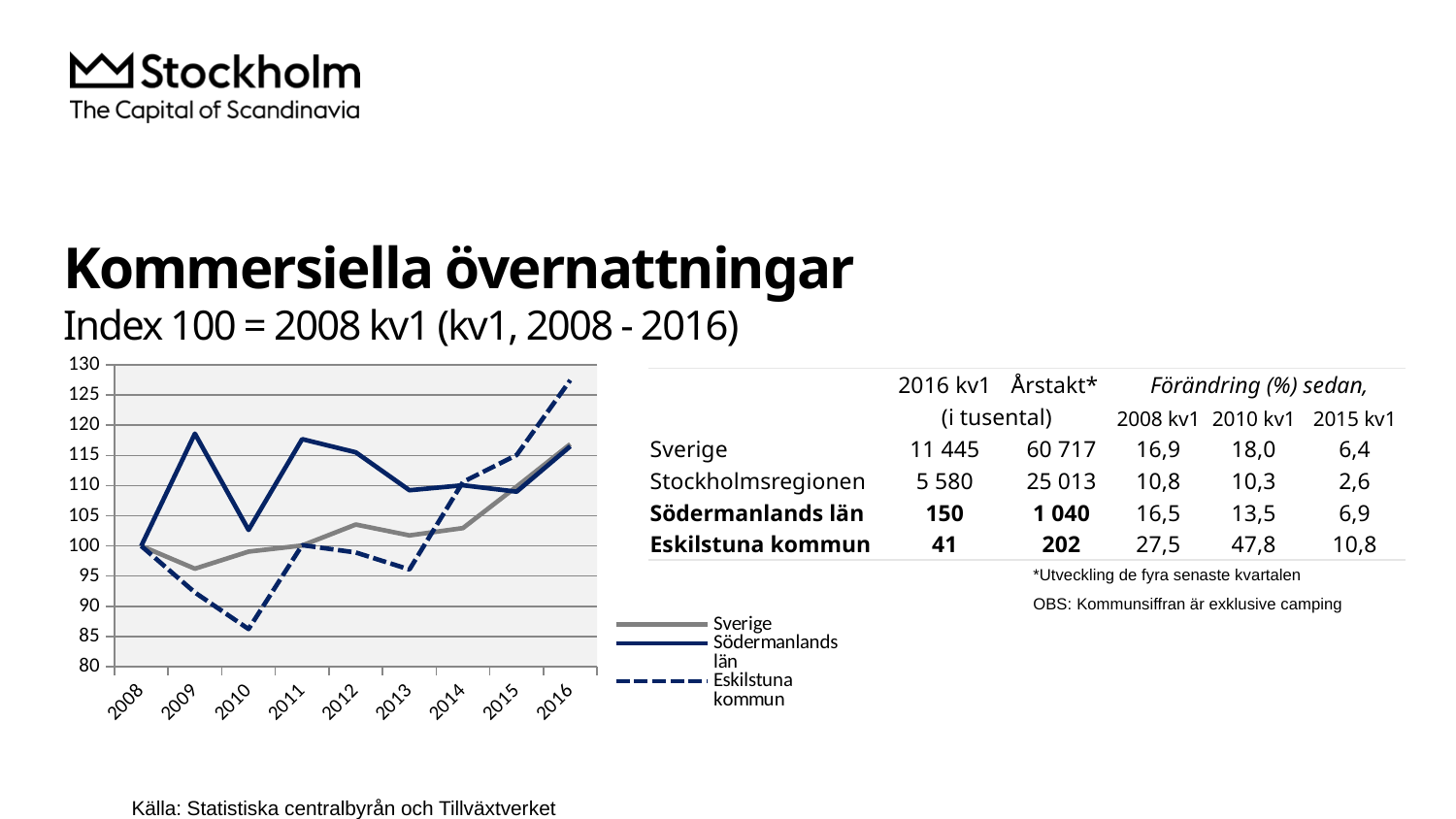
Which series has the lowest value in 2010? Eskilstuna kommun Is the value for Sverige in 2009 greater or less than 100? less What kind of chart is shown on the slide? line chart What is the index value for Sverige in 2008? 100 Is the value for Eskilstuna kommun in 2010 greater or less than 90? less How many years are plotted along the x axis of the chart? 9 Which series is drawn with a dashed line in the chart? Eskilstuna kommun Which series has the highest value in 2009? Södermanlands län Is the value for Eskilstuna kommun in 2016 greater or less than 125? greater How many series does the chart legend list? 3 In 2013, which is higher: Södermanlands län or Eskilstuna kommun? Södermanlands län